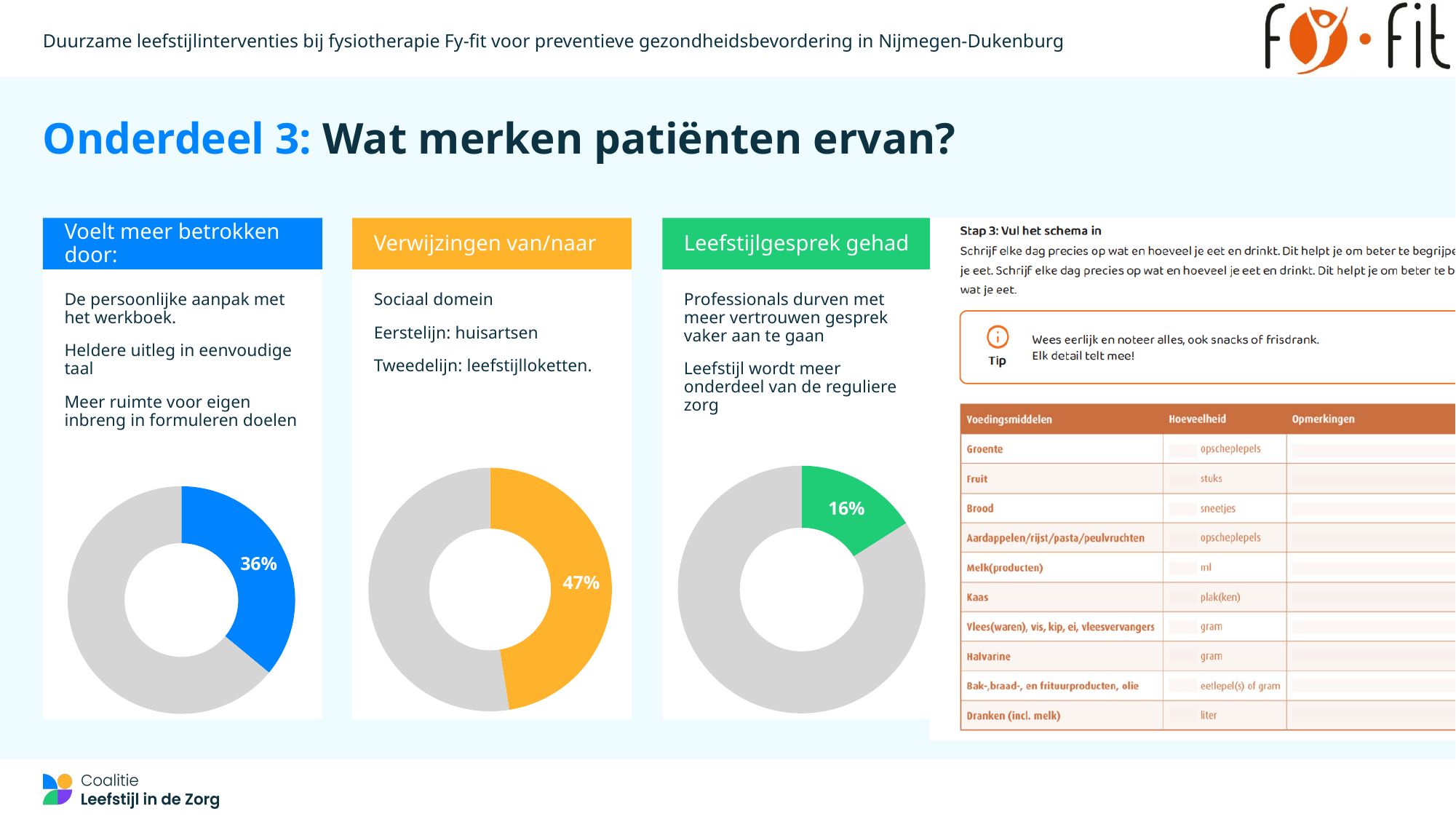
In the donut chart under 'Leefstijlgesprek gehad', what percentage is shown on the highlighted slice? 16% What is the difference in percentage points between the labelled value in the 'Voelt meer betrokken door:' chart and the 'Leefstijlgesprek gehad' chart? 20 In the donut chart under 'Verwijzingen van/naar', what percentage is shown on the highlighted slice? 47% What type of chart is used under the heading 'Verwijzingen van/naar'? Donut chart Which of the three donut charts shows the lowest labelled percentage? Leefstijlgesprek gehad Which is larger: the labelled percentage in the 'Voelt meer betrokken door:' chart or in the 'Leefstijlgesprek gehad' chart? Voelt meer betrokken door: In the donut chart under 'Voelt meer betrokken door:', what percentage is shown on the highlighted slice? 36% What colour is the highlighted slice in the donut chart under 'Voelt meer betrokken door:'? Blue How many donut charts are shown on the slide? 3 What colour is the highlighted slice in the donut chart under 'Leefstijlgesprek gehad'? Green What is the difference in percentage points between the labelled value in the 'Verwijzingen van/naar' chart and the 'Voelt meer betrokken door:' chart? 11 Which of the three donut charts shows the highest labelled percentage? Verwijzingen van/naar